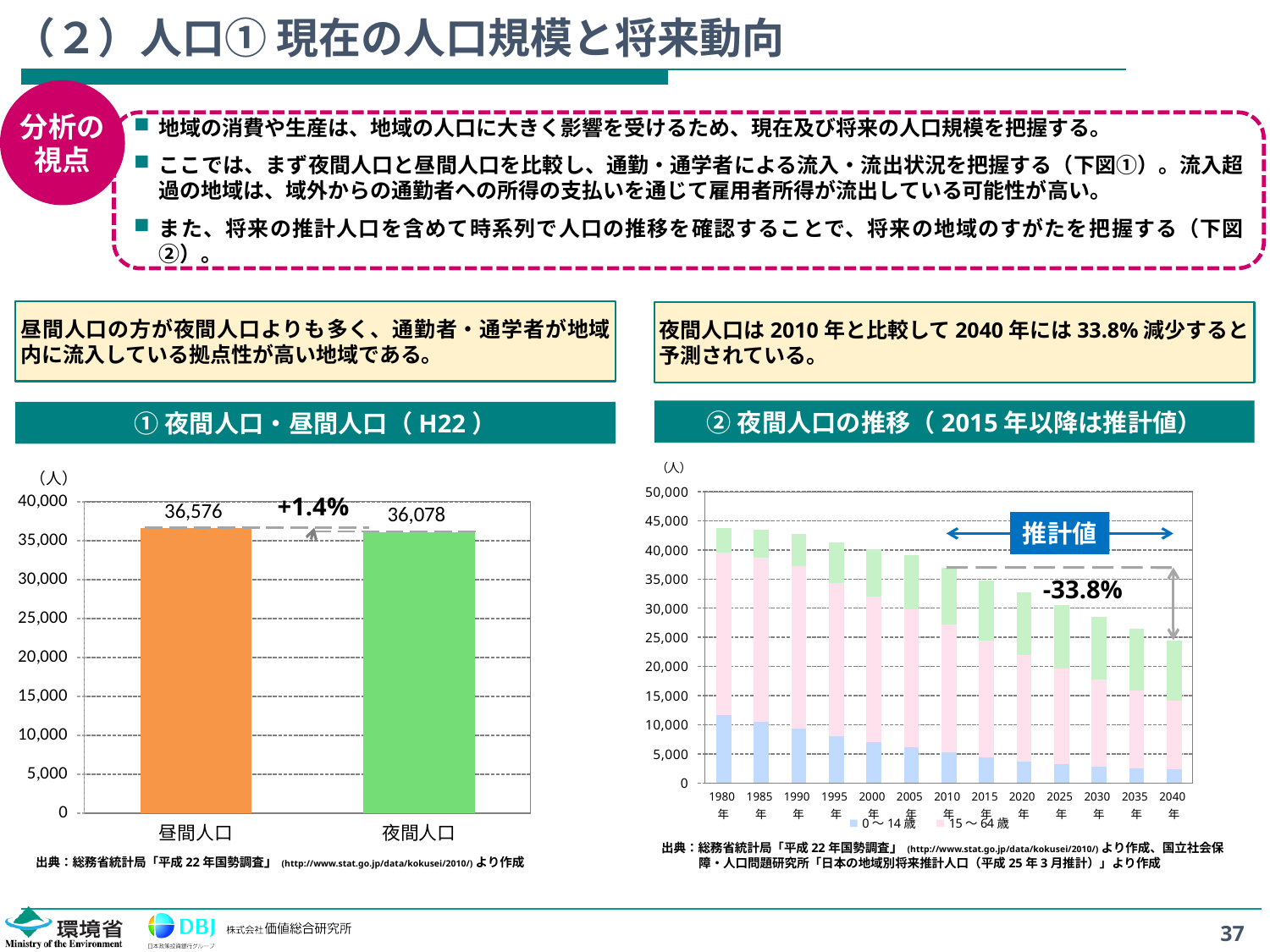
In chart ① 夜間人口・昼間人口（H22）, what is the value for 昼間人口? 36,576 In chart ② 夜間人口の推移, do the total bar heights rise or fall from 1980 to 2040? Fall In chart ② 夜間人口の推移, is the total for 2040年 greater or less than 30,000? less In chart ① 夜間人口・昼間人口（H22）, which is larger, 昼間人口 or 夜間人口? 昼間人口 How many categories are shown in chart ① 夜間人口・昼間人口（H22）? 2 How many years are plotted on the x axis of chart ② 夜間人口の推移? 13 In chart ① 夜間人口・昼間人口（H22）, what is the difference between 昼間人口 and 夜間人口? 498 In chart ① 夜間人口・昼間人口（H22）, what is the value for 夜間人口? 36,078 In chart ① 夜間人口・昼間人口（H22）, what percentage is annotated between the two bars? +1.4% What kind of chart is chart ① 夜間人口・昼間人口（H22）? Bar chart What kind of chart is chart ② 夜間人口の推移? Stacked bar chart In chart ② 夜間人口の推移, what percentage change is annotated between 2010 and 2040? -33.8%